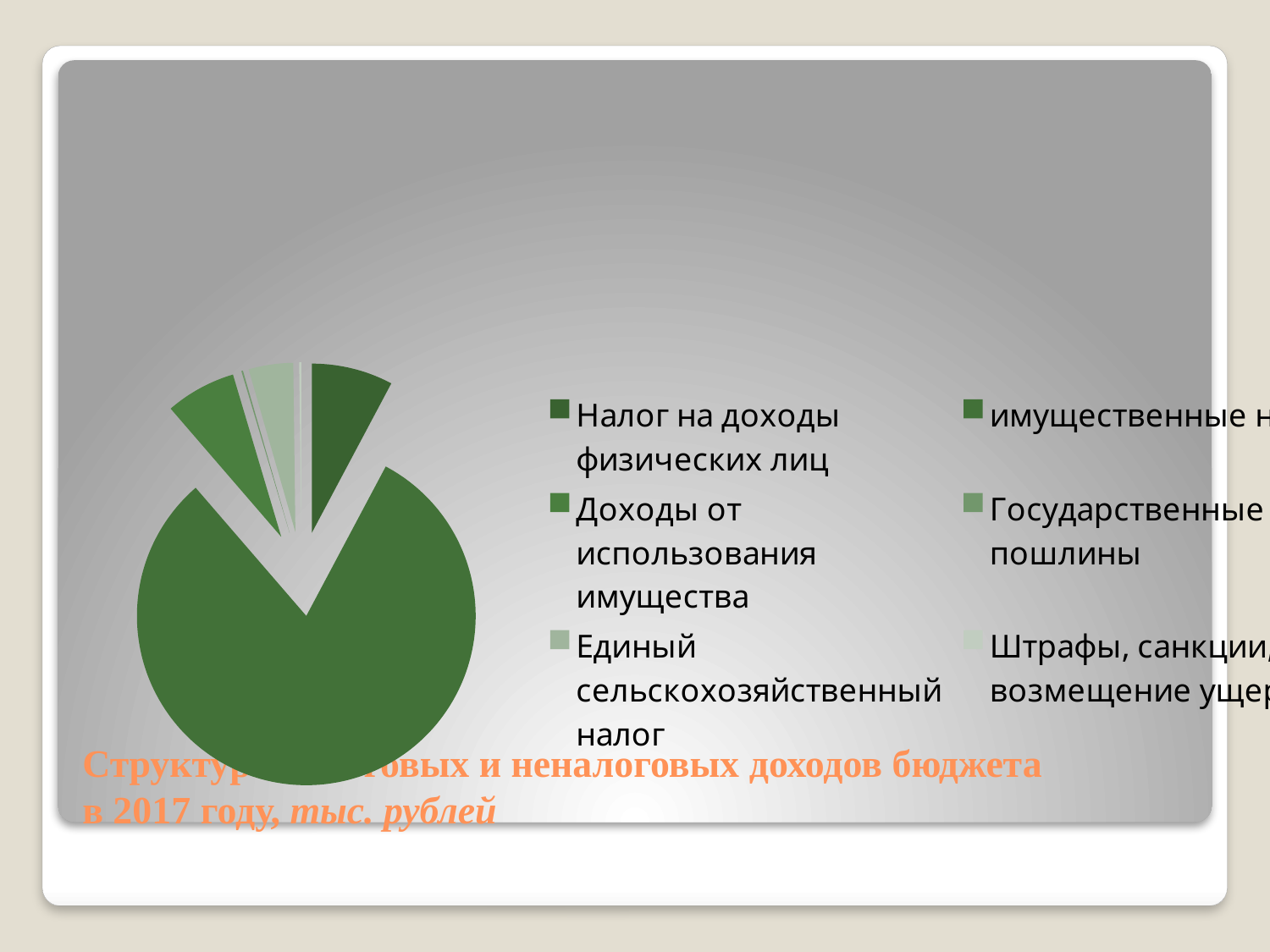
In what units does the chart title say the values are given? тыс. рублей What kind of chart is shown on the slide? pie chart Which year does the chart title say the budget income structure refers to? 2017 How many entries does the legend of the pie chart list? 6 Does the largest slice of the pie account for more or less than half of the whole pie? more